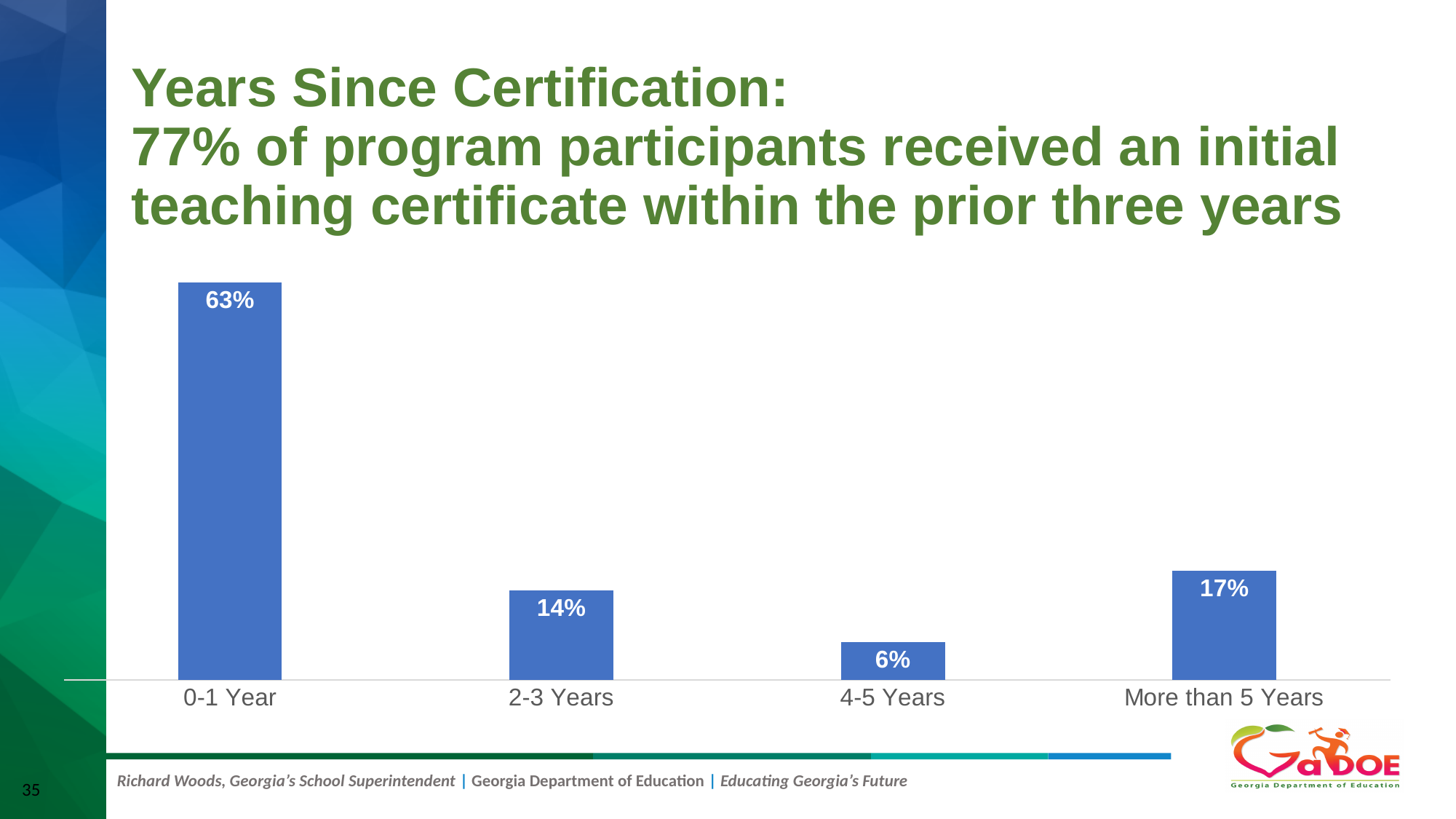
What kind of chart is shown on the slide? bar chart Which is larger, the value for 2-3 Years or the value for More than 5 Years? More than 5 Years How many categories are shown on the x axis? 4 Which category has the lowest value? 4-5 Years What is the value for 4-5 Years? 6% Which category has the highest value? 0-1 Year What colour are the bars in the chart? blue What is the difference between the values for 0-1 Year and 2-3 Years? 49% What is the value for 0-1 Year? 63% What is the difference between the values for More than 5 Years and 4-5 Years? 11% What is the value for 2-3 Years? 14% What is the value for More than 5 Years? 17%